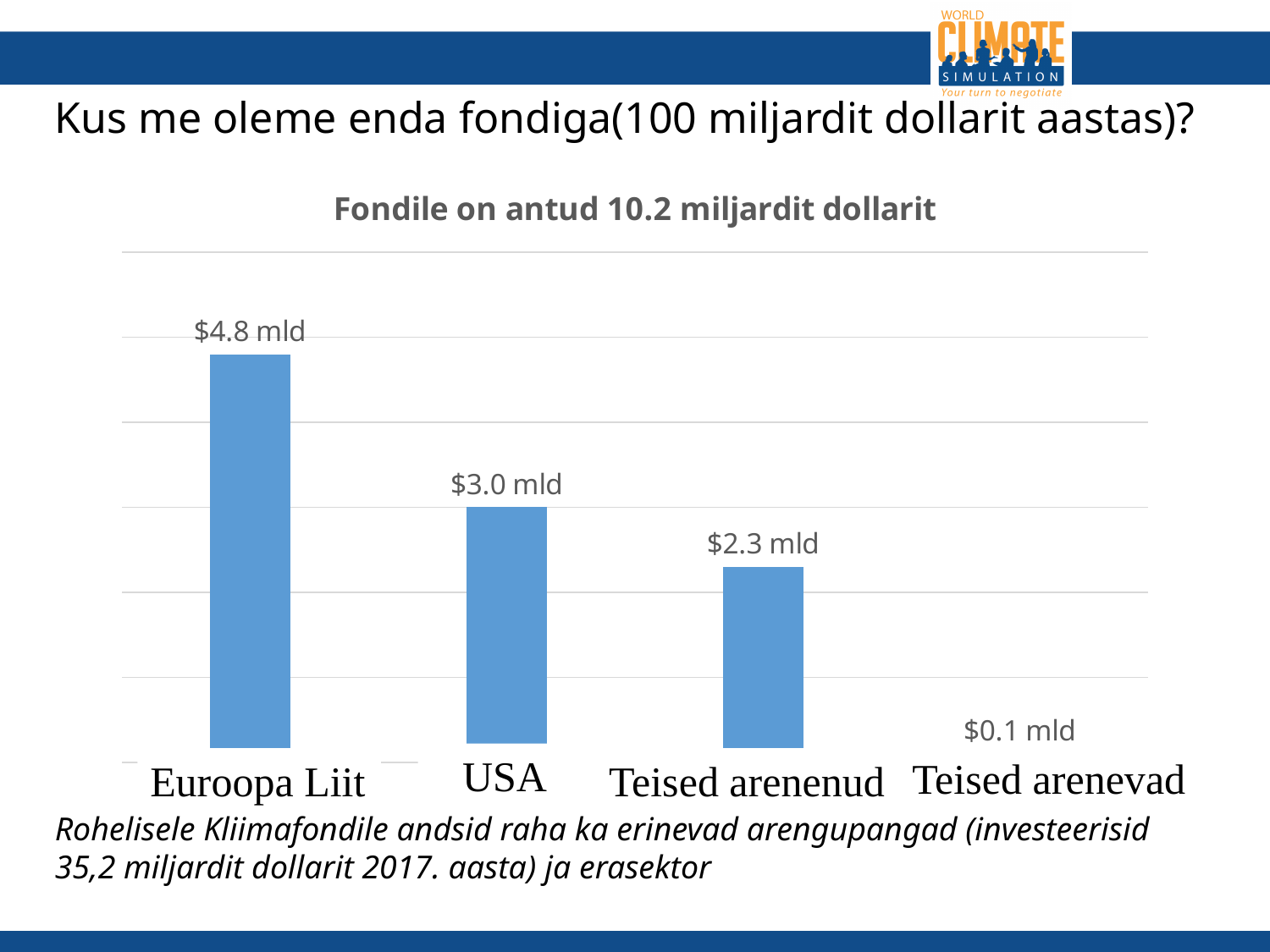
Which category has the lowest value? Teised arenevad What kind of chart is shown on the slide? Bar chart Which is larger, the value for USA or the value for Teised arenenud? USA What is the value for Teised arenenud? $2.3 mld What is the difference between the values for Euroopa Liit and USA? $1.8 mld What is the value for Euroopa Liit? $4.8 mld What is the value for USA? $3.0 mld What is the title of the chart? Fondile on antud 10.2 miljardit dollarit How many categories are shown in the chart? 4 What is the value for Teised arenevad? $0.1 mld Which category has the highest value? Euroopa Liit What is the difference between the values for USA and Teised arenenud? $0.7 mld